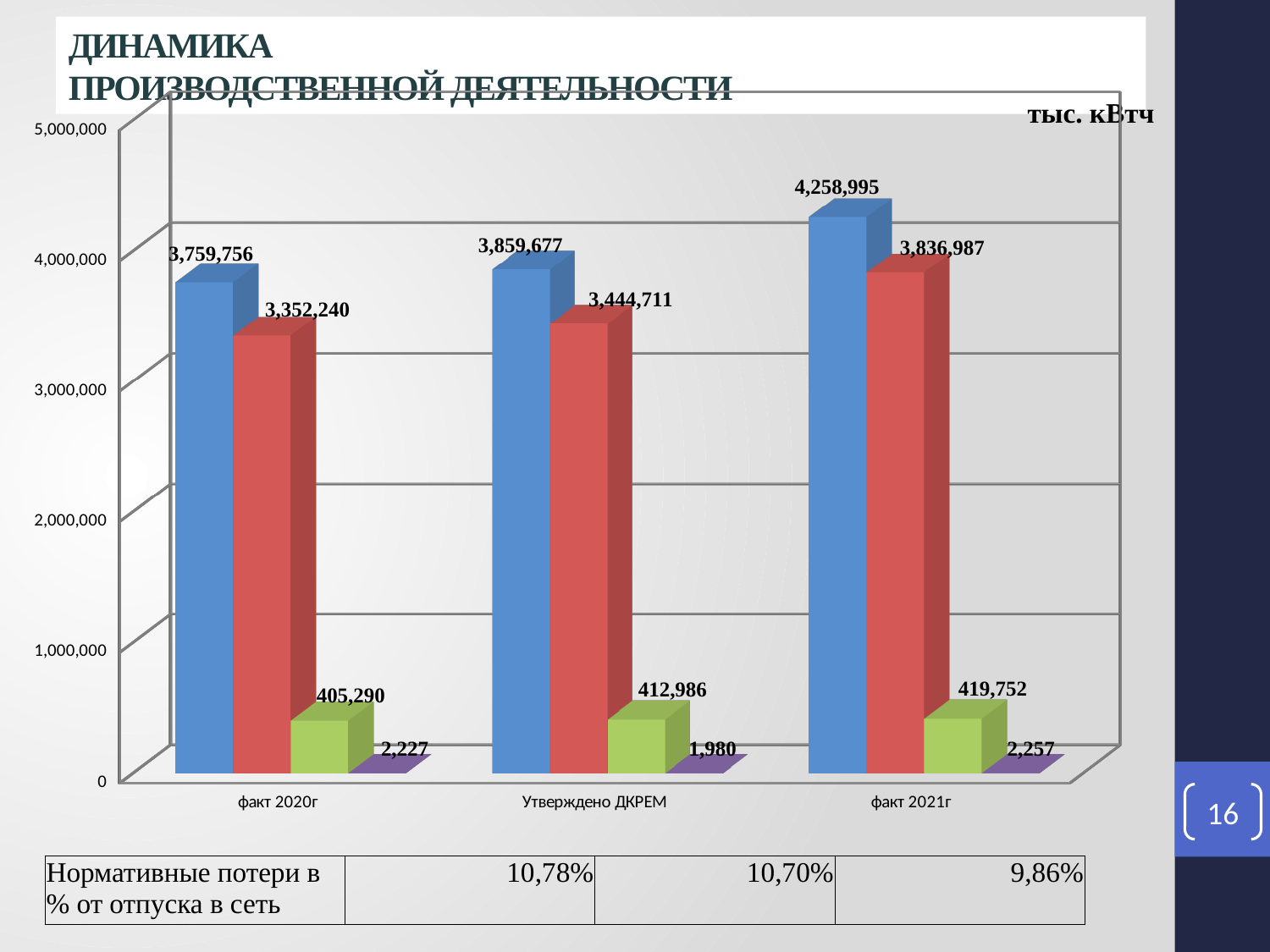
What is the value of the blue bar for факт 2021г? 4,258,995 How many categories are shown on the x axis? 3 For which category is the purple bar the lowest? Утверждено ДКРЕМ Which is larger: the green bar for Утверждено ДКРЕМ or the green bar for факт 2021г? факт 2021г What is the difference between the blue bar and the red bar for факт 2021г? 422,008 What is the value of the red bar for Утверждено ДКРЕМ? 3,444,711 By how much does the blue bar for факт 2021г exceed the blue bar for факт 2020г? 499,239 What is the value of the purple bar for факт 2021г? 2,257 For which category is the blue bar the highest? факт 2021г What is the value of the green bar for факт 2020г? 405,290 Is the value of the red bar for факт 2020г greater or less than 3,000,000? greater What unit is shown in the top right corner of the chart? тыс. кВтч